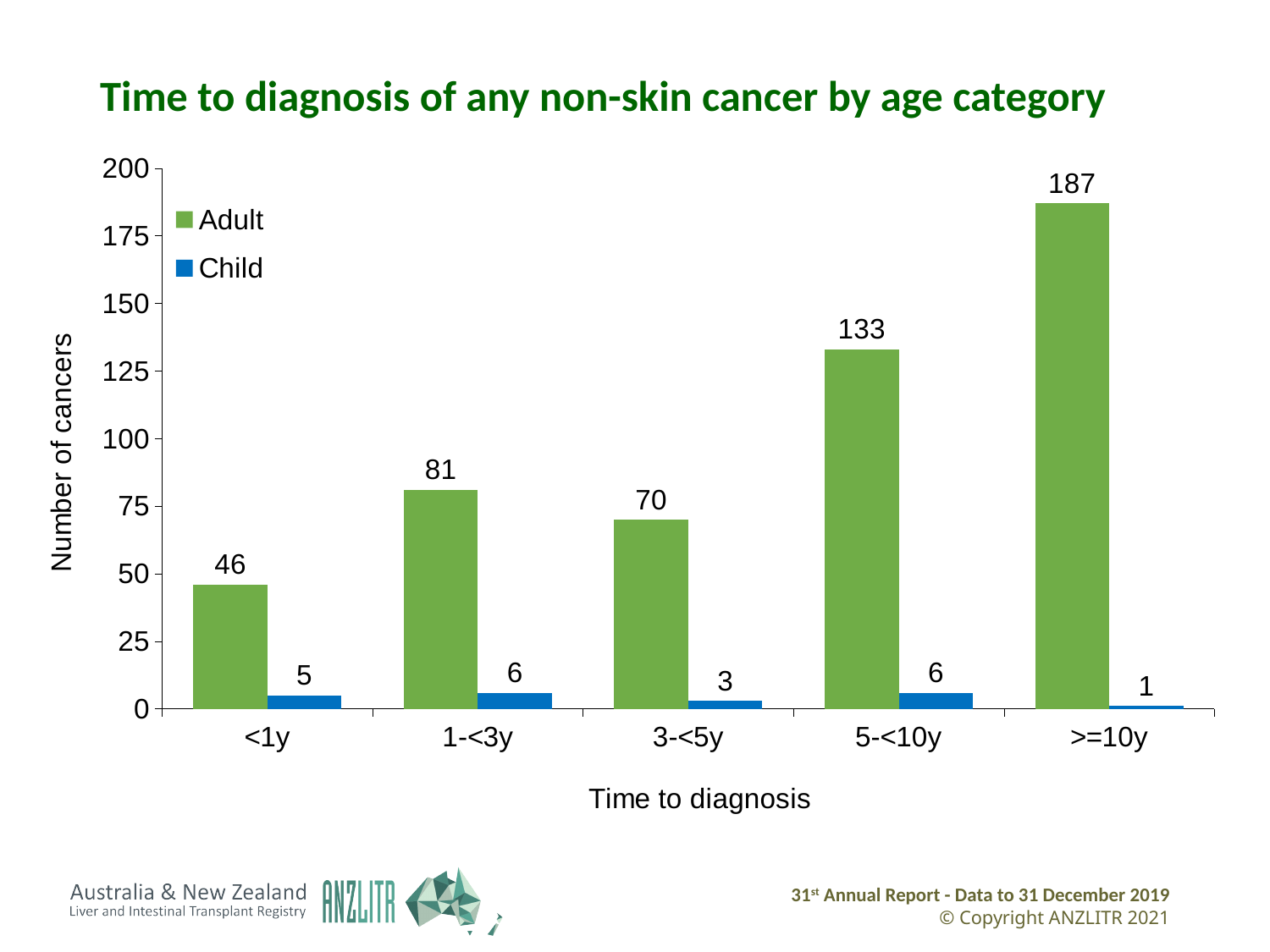
What is the number of cancers for Child in the 3-<5y category? 3 What is the difference between the Adult values for >=10y and 5-<10y? 54 What is the number of cancers for Adult in the >=10y category? 187 Is the Adult value for 5-<10y greater or less than 125? greater How many series does the legend list? 2 Which time-to-diagnosis category has the lowest Child value? >=10y How many time-to-diagnosis categories are shown on the x axis? 5 What is the label of the y axis? Number of cancers Which time-to-diagnosis category has the highest Adult value? >=10y What is the number of cancers for Adult in the 1-<3y category? 81 What kind of chart is shown on the slide? Bar chart Which is larger, the Adult value for 1-<3y or the Adult value for 3-<5y? 1-<3y